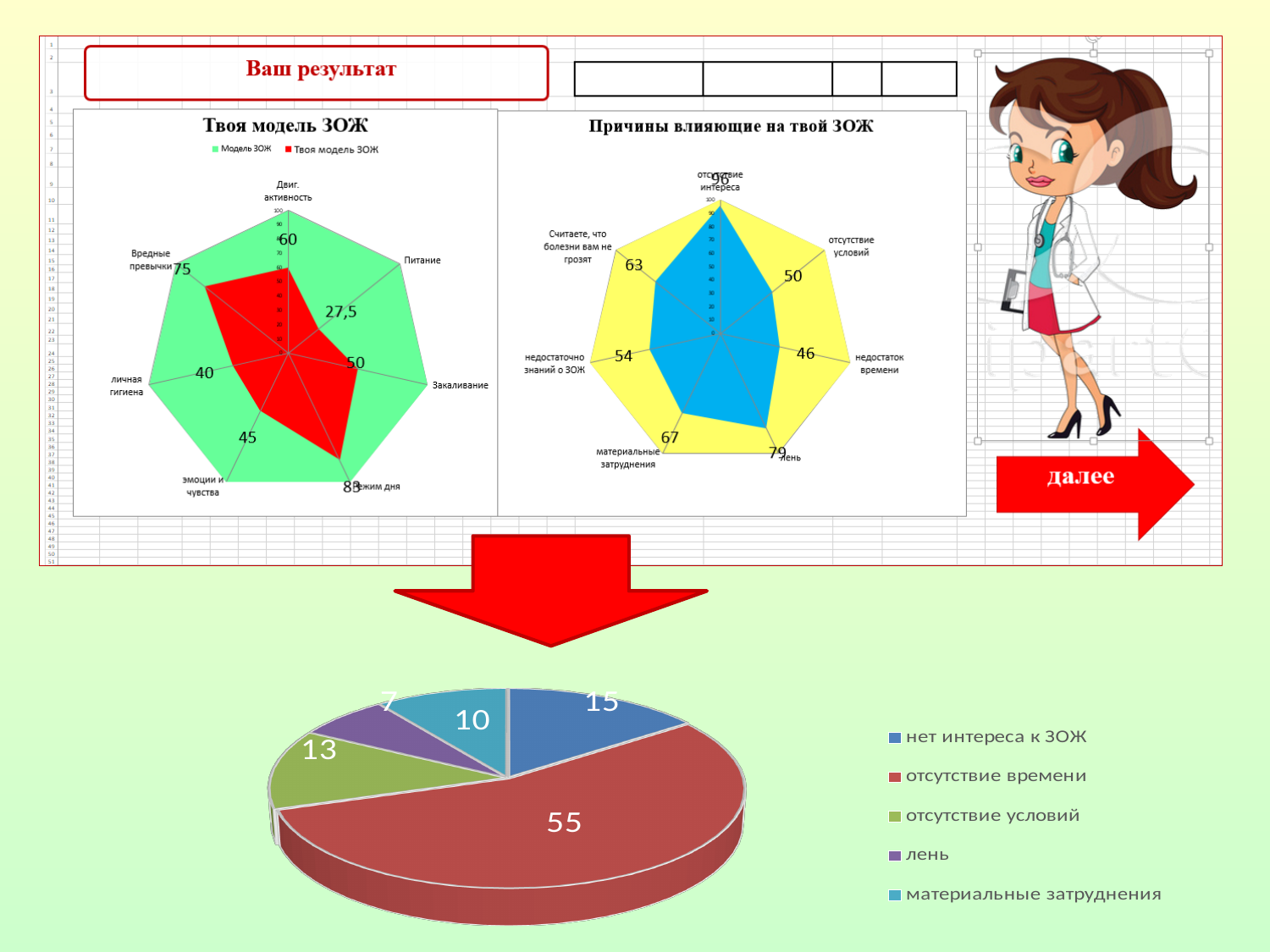
In the chart titled 'Причины влияющие на твой ЗОЖ', what value is shown for 'лень'? 79 In the chart titled 'Твоя модель ЗОЖ', what value is shown for 'Вредные привычки'? 75 In the pie chart at the bottom of the slide, what value is shown for 'отсутствие времени'? 55 In the pie chart at the bottom of the slide, which category has the smallest slice? лень In the pie chart at the bottom of the slide, which category has the largest slice? отсутствие времени What type of chart is shown at the bottom of the slide? pie chart In the pie chart at the bottom of the slide, what value is shown for 'лень'? 7 How many categories does the legend of the pie chart at the bottom of the slide list? 5 In the chart titled 'Твоя модель ЗОЖ', what value is shown for 'Питание'? 27,5 In the pie chart at the bottom of the slide, what is the difference between the values for 'нет интереса к ЗОЖ' and 'материальные затруднения'? 5 How many series does the legend of the chart titled 'Твоя модель ЗОЖ' list? 2 In the chart titled 'Причины влияющие на твой ЗОЖ', which is larger: the value for 'отсутствие условий' or the value for 'материальные затруднения'? материальные затруднения